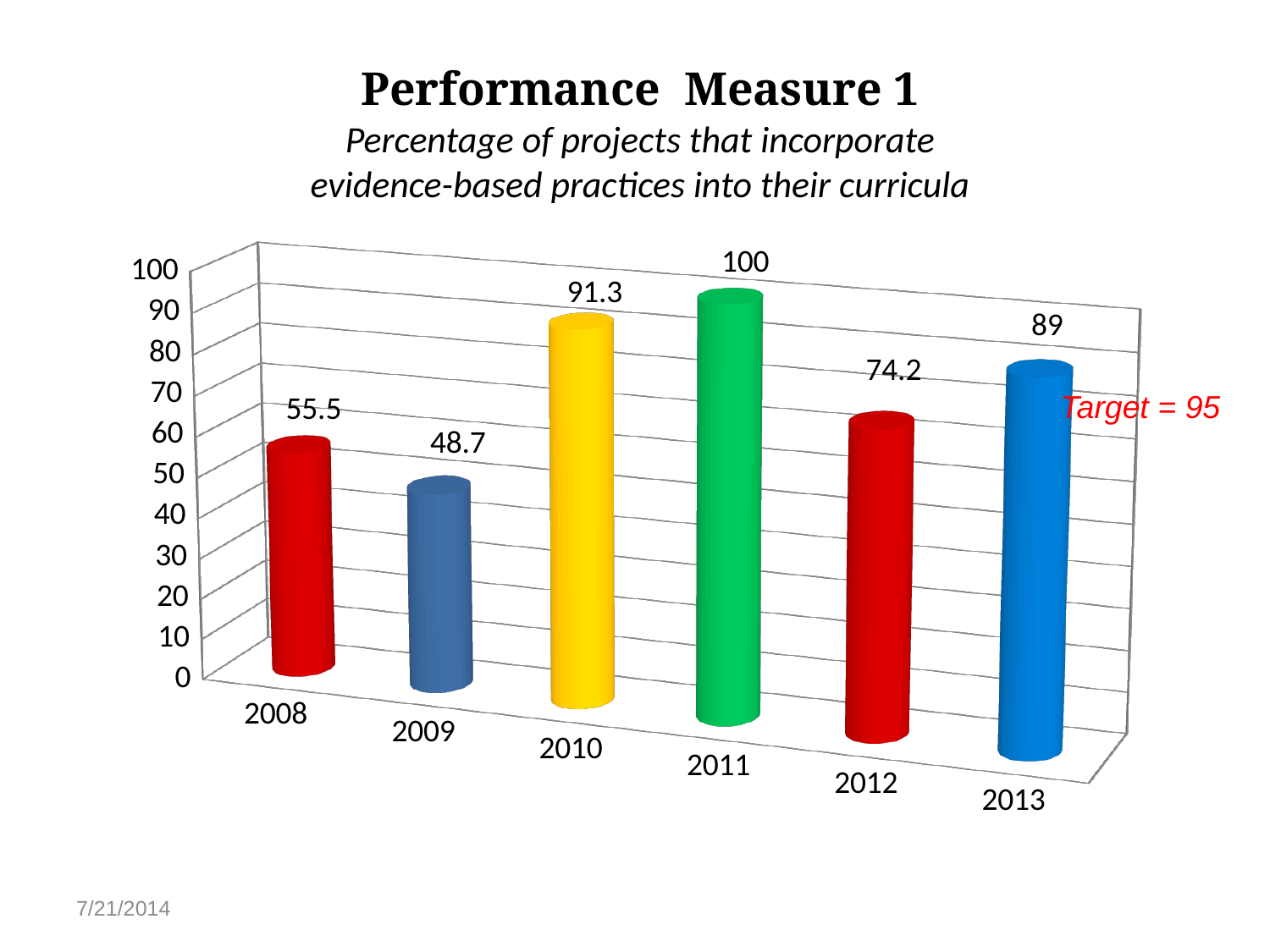
Which year has the lowest value? 2009 What is the value for 2011? 100 What is the value for 2013? 89 How many years are shown on the x axis? 6 Which year has the highest value? 2011 What is the value for 2008? 55.5 Do the values rise or fall from 2011 to 2012? fall What kind of chart is shown on the slide? bar chart What colour is the bar for 2011? green Which is larger, the value for 2008 or the value for 2009? 2008 What is the difference between the values for 2010 and 2012? 17.1 What target value is noted on the chart? Target = 95